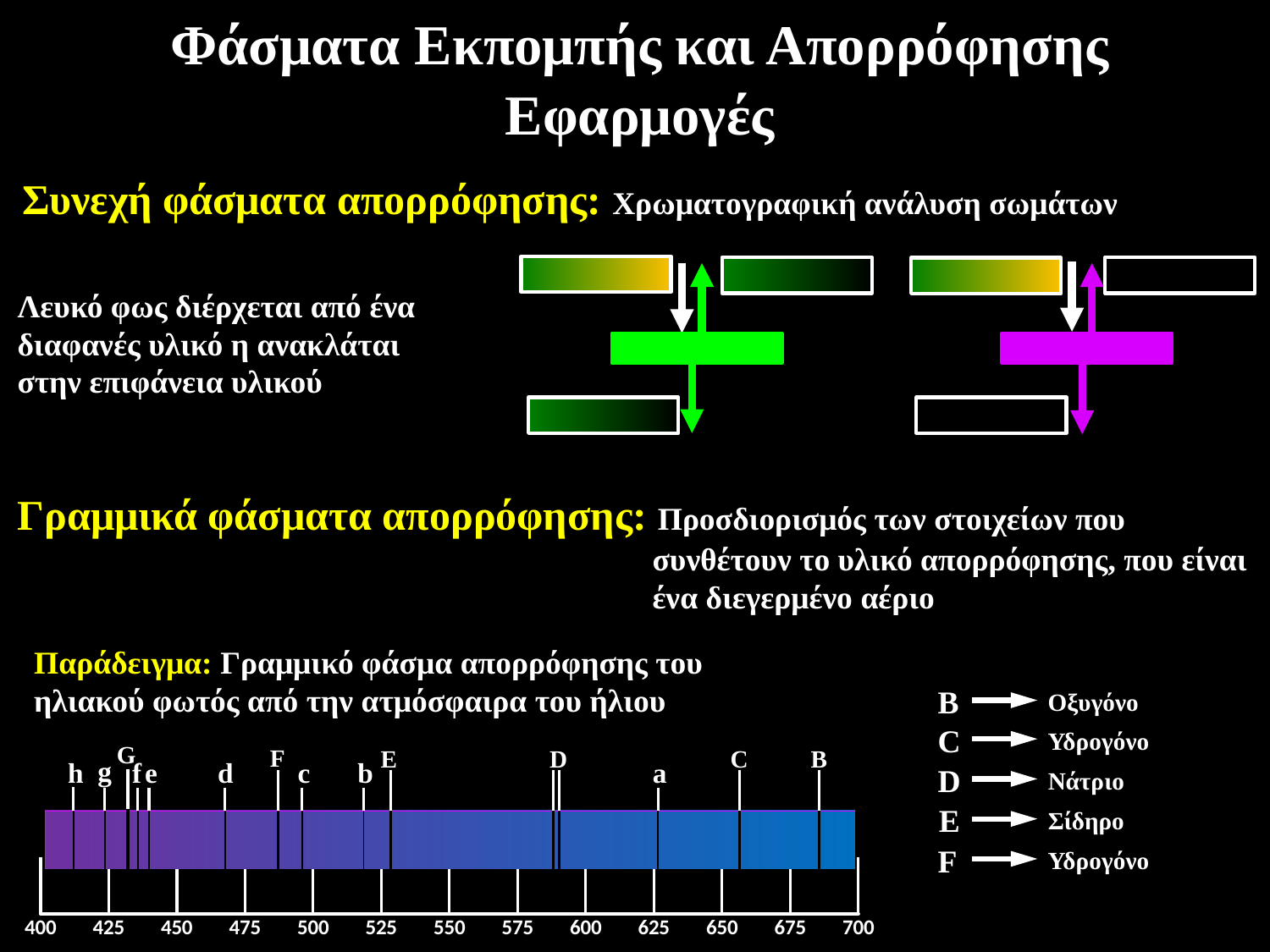
On the absorption spectrum, is the line labeled b at a wavelength greater or less than 525? less On the absorption spectrum, is the line labeled C at a wavelength greater or less than 650? greater On the absorption spectrum, is the line labeled d at a wavelength greater or less than 475? less On the absorption spectrum, which labeled line is at the shortest wavelength? h What are the lowest and highest wavelength values shown on the axis of the absorption spectrum? 400 and 700 According to the key next to the absorption spectrum, which element does line D correspond to? Νάτριο On the absorption spectrum, which labeled line is at the longest wavelength? B